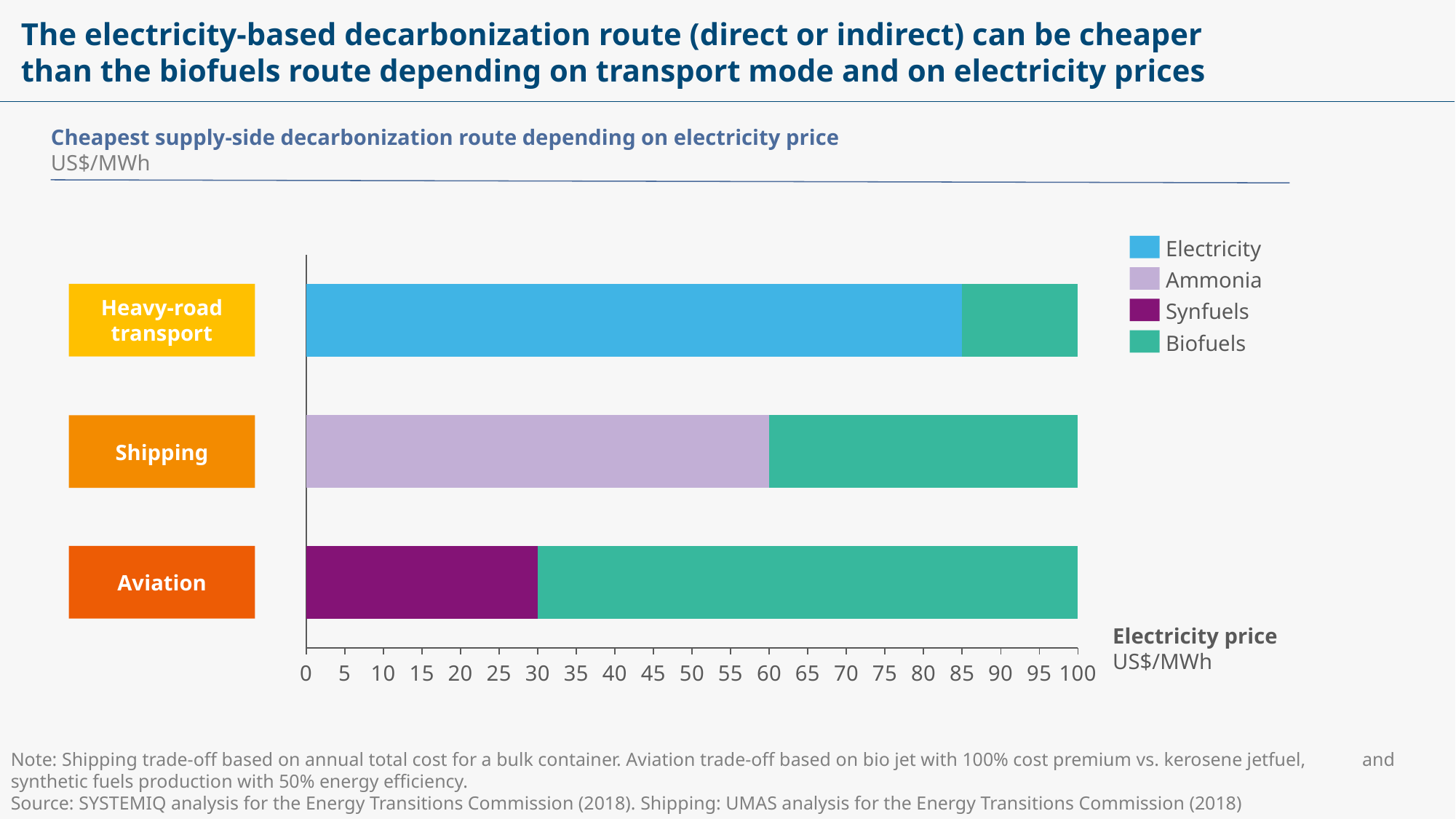
How many transport modes (categories) are shown on the chart? 3 At what electricity price (US$/MWh) does the Synfuels segment for Aviation end? 30 What kind of chart is shown on the slide? Stacked bar chart Is the end of the Synfuels segment for Aviation greater or less than 50 US$/MWh? less At what electricity price (US$/MWh) does the Electricity segment for Heavy-road transport end? 85 What is the difference between the end of the Electricity segment for Heavy-road transport and the end of the Ammonia segment for Shipping, in US$/MWh? 25 At what electricity price (US$/MWh) does the Ammonia segment for Shipping end? 60 Which transport mode has the shortest electricity-based (non-biofuel) segment? Aviation How many series does the legend list? 4 Is the Ammonia segment for Shipping longer or shorter than the Synfuels segment for Aviation? Longer Which series is shown in green on the chart? Biofuels Which transport mode has the longest electricity-based (non-biofuel) segment? Heavy-road transport